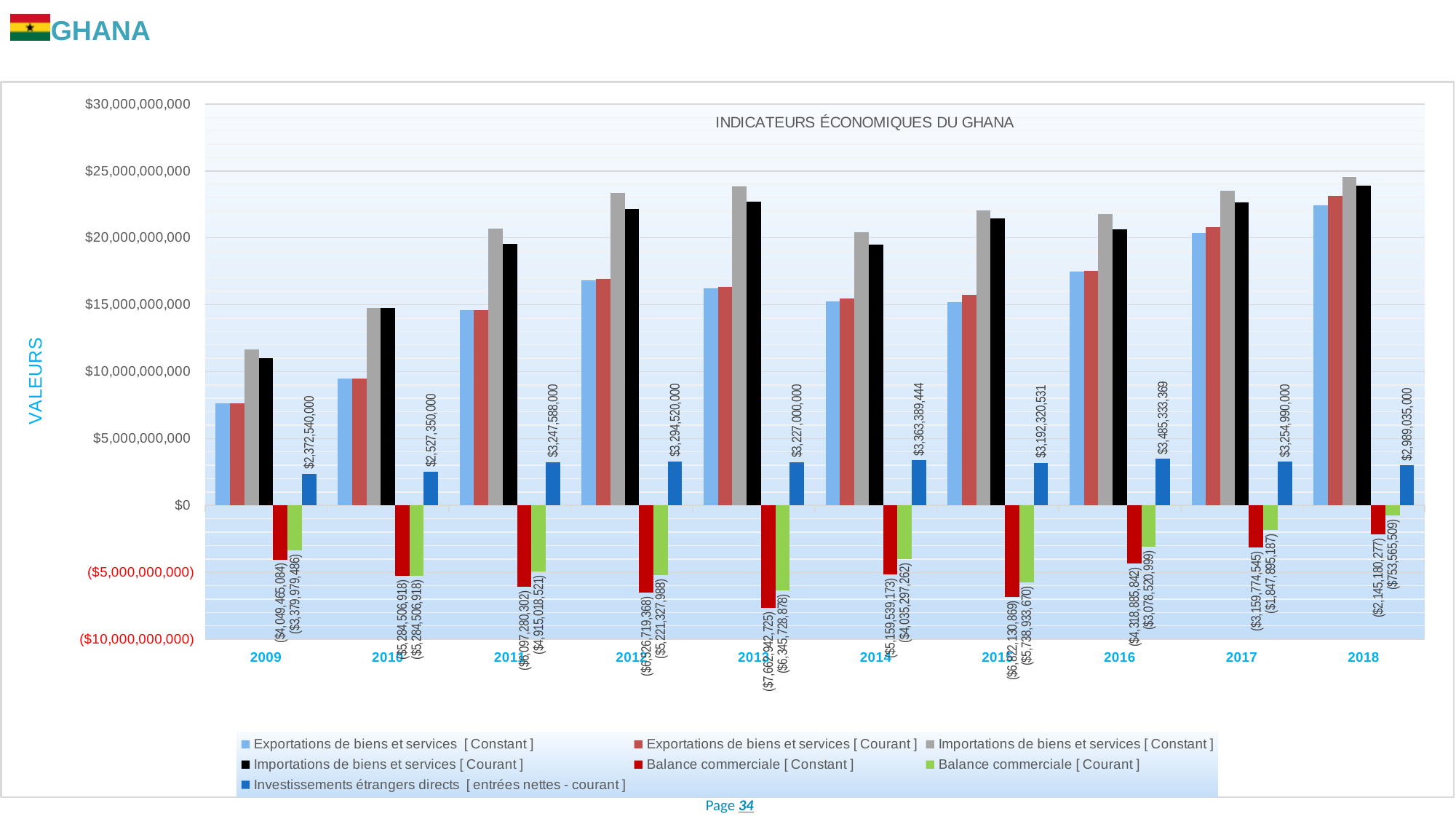
What is the value of Balance commerciale [ Courant ] for 2018? ($753,565,509) What is the value of Investissements étrangers directs for 2009? $2,372,540,000 How many series does the chart's legend list? 7 Which is larger: Investissements étrangers directs in 2016 or in 2009? 2016 What is the title of the chart? INDICATEURS ÉCONOMIQUES DU GHANA How many years are shown on the x axis of the chart? 10 In which year is Investissements étrangers directs highest? 2016 Is the value of Exportations de biens et services [ Constant ] for 2018 greater or less than $20,000,000,000? greater In which year is Investissements étrangers directs lowest? 2009 What is the value of Investissements étrangers directs for 2014? $3,363,389,444 What is the difference between Investissements étrangers directs in 2010 and in 2009? $154,810,000 What kind of chart is shown on the slide? bar chart